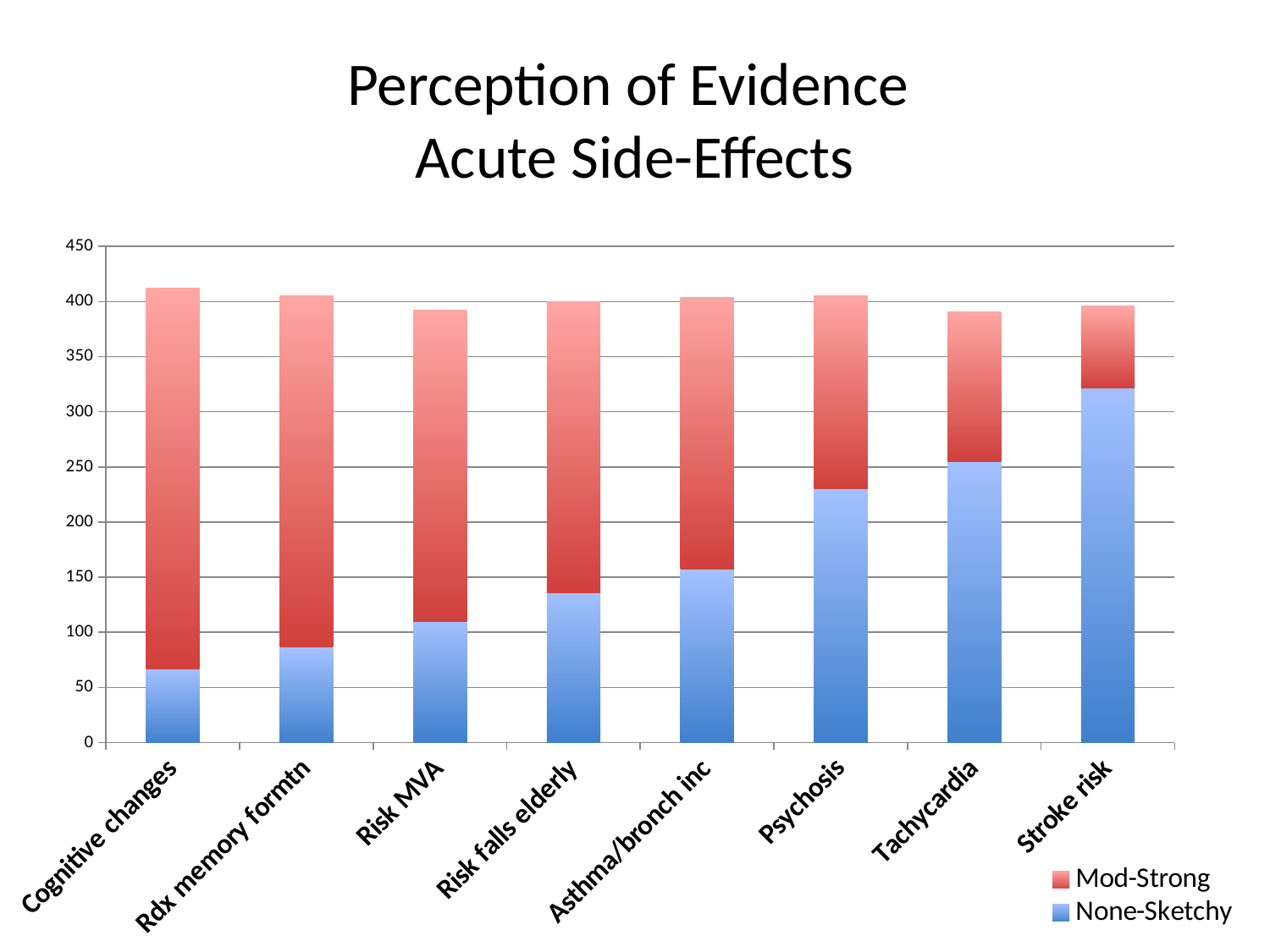
Is the None-Sketchy value for Risk falls elderly greater or less than 150? less Which colour represents the Mod-Strong series? Red Which category has the highest None-Sketchy value? Stroke risk How many series does the legend list? 2 Which category has the lowest None-Sketchy value? Cognitive changes Is the None-Sketchy value for Psychosis greater or less than 250? less Do the None-Sketchy values rise or fall moving left to right along the x axis? Rise Is the None-Sketchy value for Cognitive changes greater or less than 100? less How many side-effect categories are shown on the x axis? 8 What kind of chart is shown on the slide? Stacked bar chart Which has the larger None-Sketchy value, Psychosis or Risk MVA? Psychosis